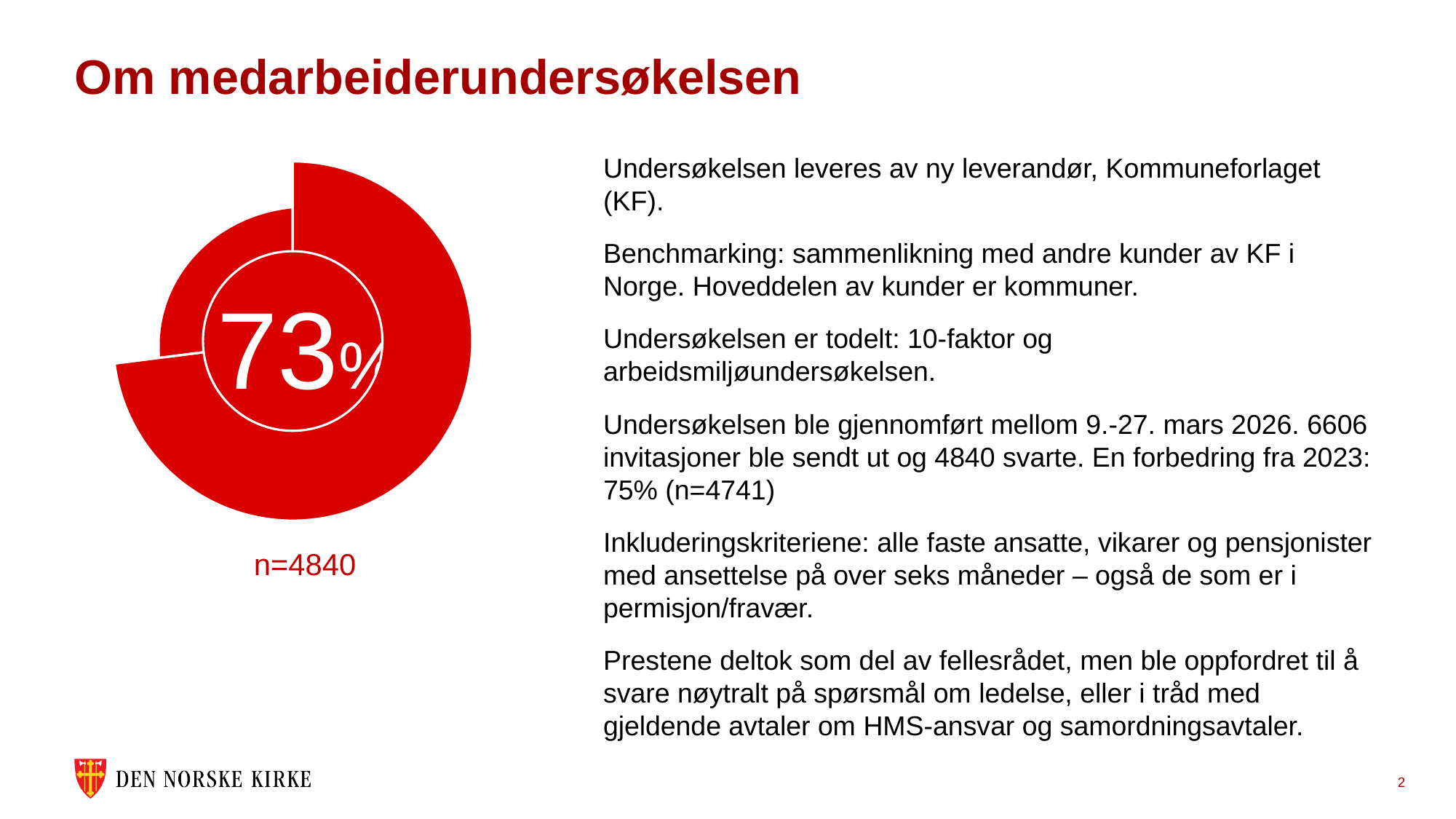
What colour is the filled slice of the pie chart? red What share of the pie chart is not covered by the red slice? 27% Is the value shown in the pie chart greater or less than 50%? greater What percentage is displayed in the centre of the pie chart? 73% What is the n value printed below the pie chart? n=4840 Does the pie chart show a response rate above 70%? yes Which portion of the pie chart is larger, the red slice or the white portion? the red slice What kind of chart is shown on the left of the slide? doughnut chart